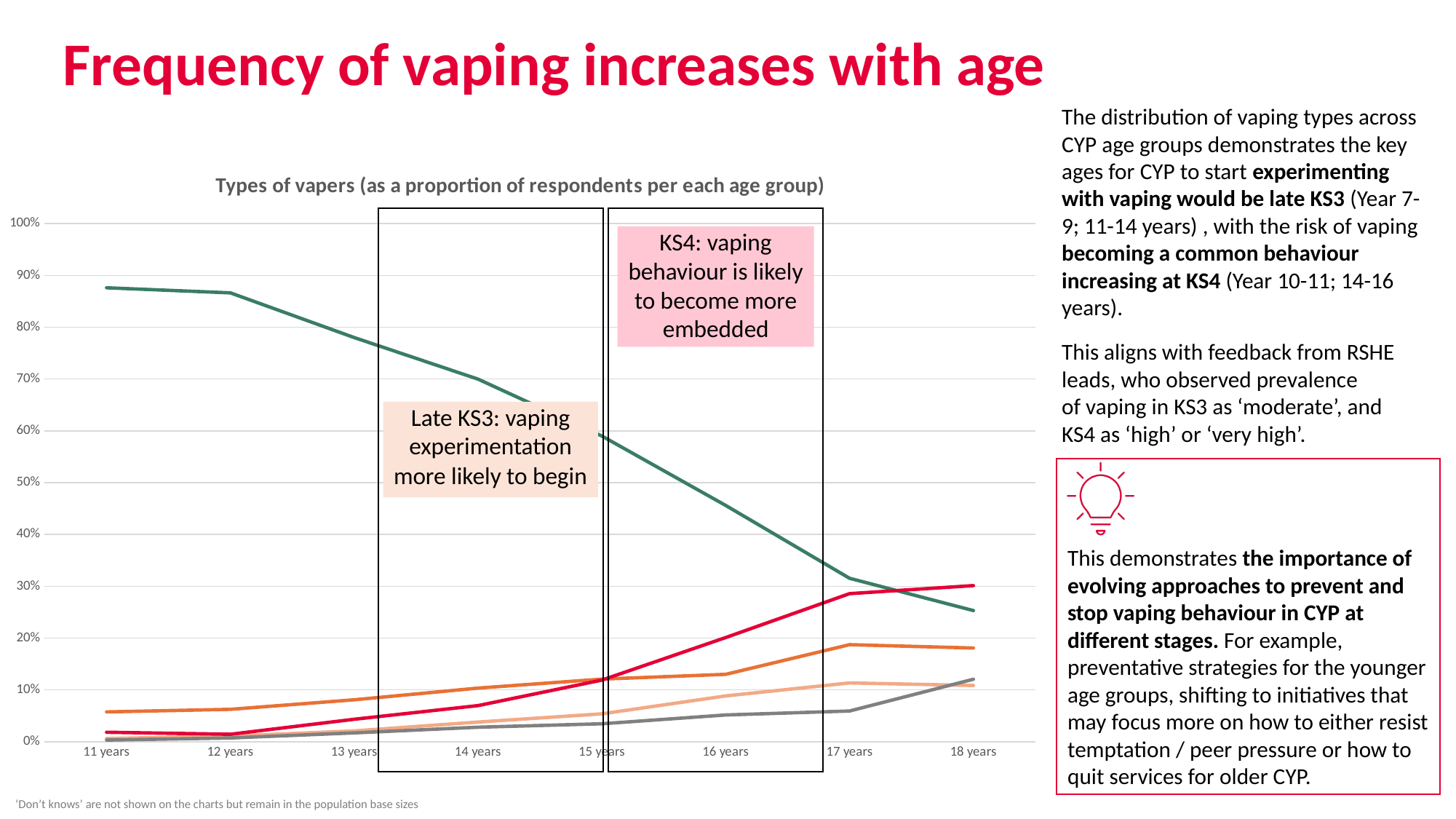
What is the title of the chart? Types of vapers (as a proportion of respondents per each age group) At 18 years, which line is higher: the red line or the green line? the red line What does the pink annotation box on the chart say about KS4? KS4: vaping behaviour is likely to become more embedded How many age groups are shown on the x axis of the chart? 8 Is the value of the orange line at 18 years greater or less than 20%? less Does the green line rise or fall as age increases from 11 years to 18 years? fall At which age group is the green line at its lowest? 18 years What kind of chart is shown on the slide? line chart Is the value of the green line at 11 years greater or less than 80%? greater Is the value of the green line at 16 years greater or less than 50%? less At which age group is the green line at its highest? 11 years Does the red line rise or fall as age increases from 11 years to 18 years? rise